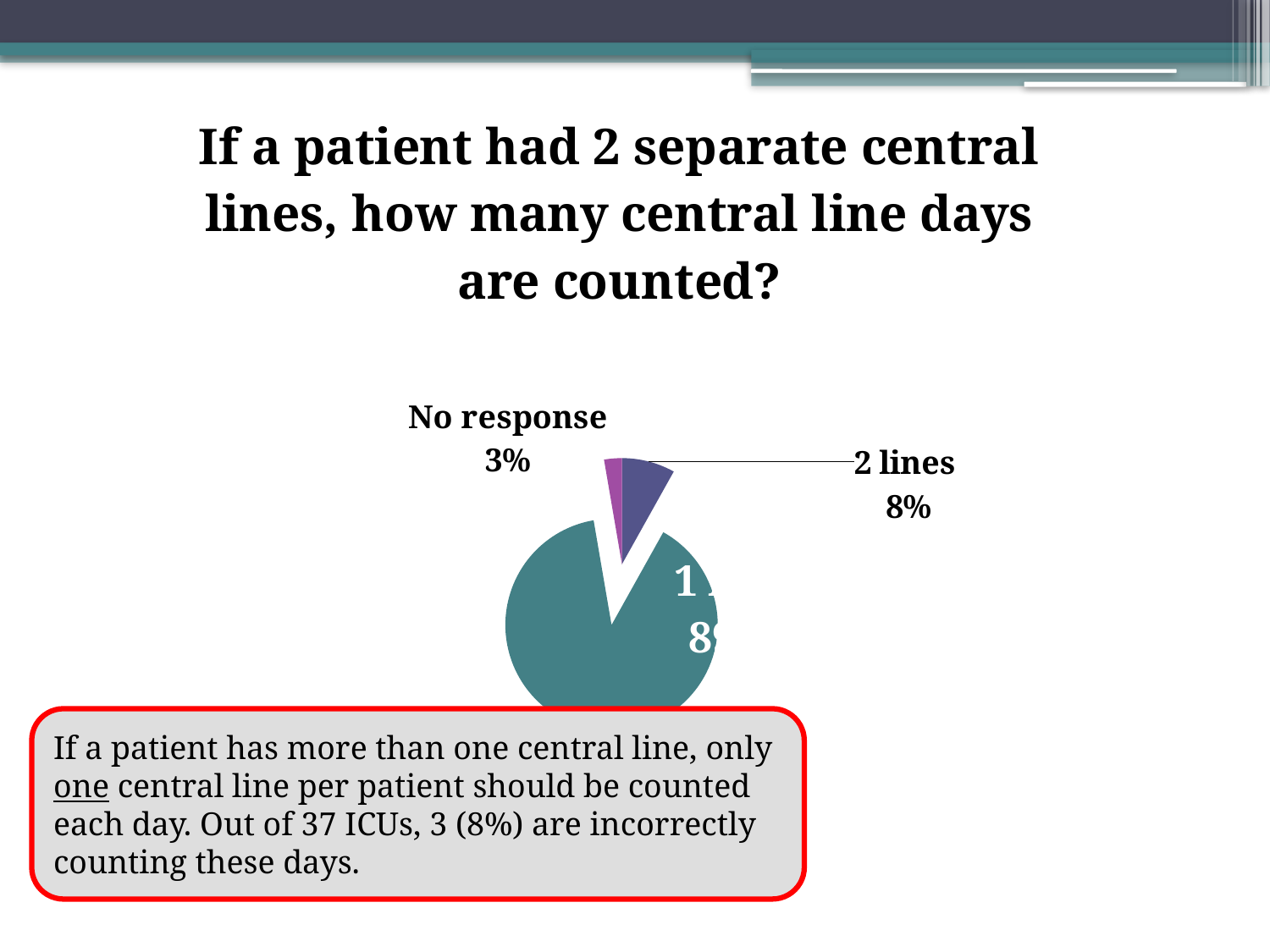
Which category has the smallest share of the pie? No response How many slices does the pie chart have? 3 What colour is the largest slice of the pie chart? Teal What kind of chart is shown on the slide? Pie chart Which is larger, the share for "2 lines" or the share for "No response"? 2 lines What share of the pie does the "No response" slice represent? 3% What share of the pie does the "2 lines" slice represent? 8% What is the title of the slide above the chart? If a patient had 2 separate central lines, how many central line days are counted? What is the difference in percentage points between the "2 lines" share and the "No response" share? 5 percentage points